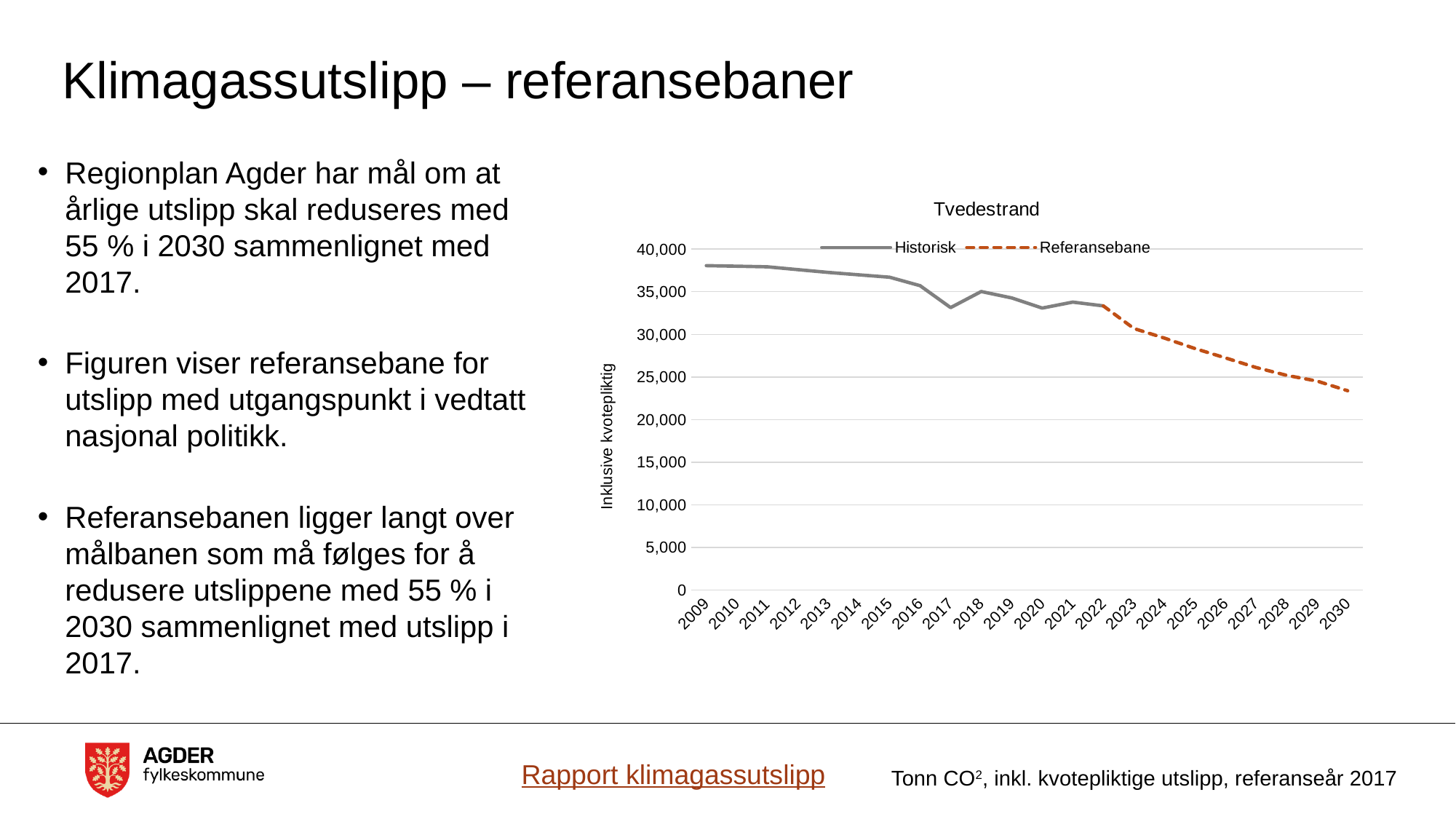
Which series is drawn with a dashed line? Referansebane How many series does the chart legend list? 2 Which is larger, the value for 2009 or the value for 2030? 2009 Is the value for 2030 greater or less than 25,000? less Is the value for 2025 greater or less than 30,000? less How many years are shown on the x axis of the chart? 22 Is the value for 2009 greater or less than 35,000? greater What is the title of the chart? Tvedestrand Do the values generally rise or fall from 2009 to 2030? fall What kind of chart is shown on the slide? line chart Which year has the lowest value in the chart? 2030